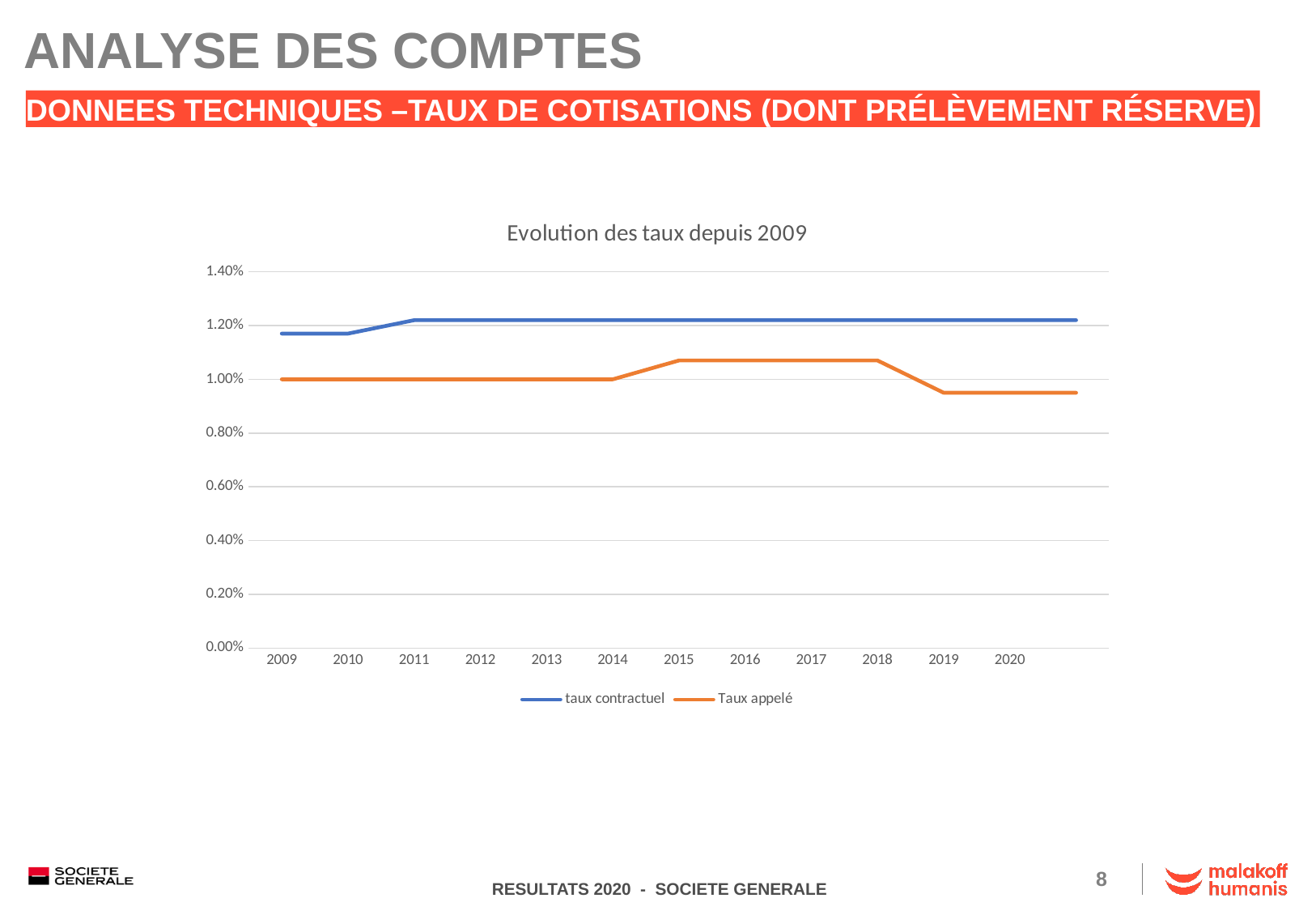
Is the value for 'Taux appelé' in 2016 greater or less than 1.00%? greater How many year labels are shown on the x axis? 12 Which colour is used for the 'Taux appelé' series? orange How many series does the legend list? 2 Is the value for 'Taux appelé' in 2020 greater or less than 1.00%? less Is the value for 'taux contractuel' in 2009 greater or less than 1.20%? less What kind of chart is shown on the slide? line chart In 2020, which series has the higher value, 'taux contractuel' or 'Taux appelé'? taux contractuel Does the 'Taux appelé' series rise or fall between 2018 and 2019? fall What is the value of 'Taux appelé' in 2010? 1.00% What is the title of the chart? Evolution des taux depuis 2009